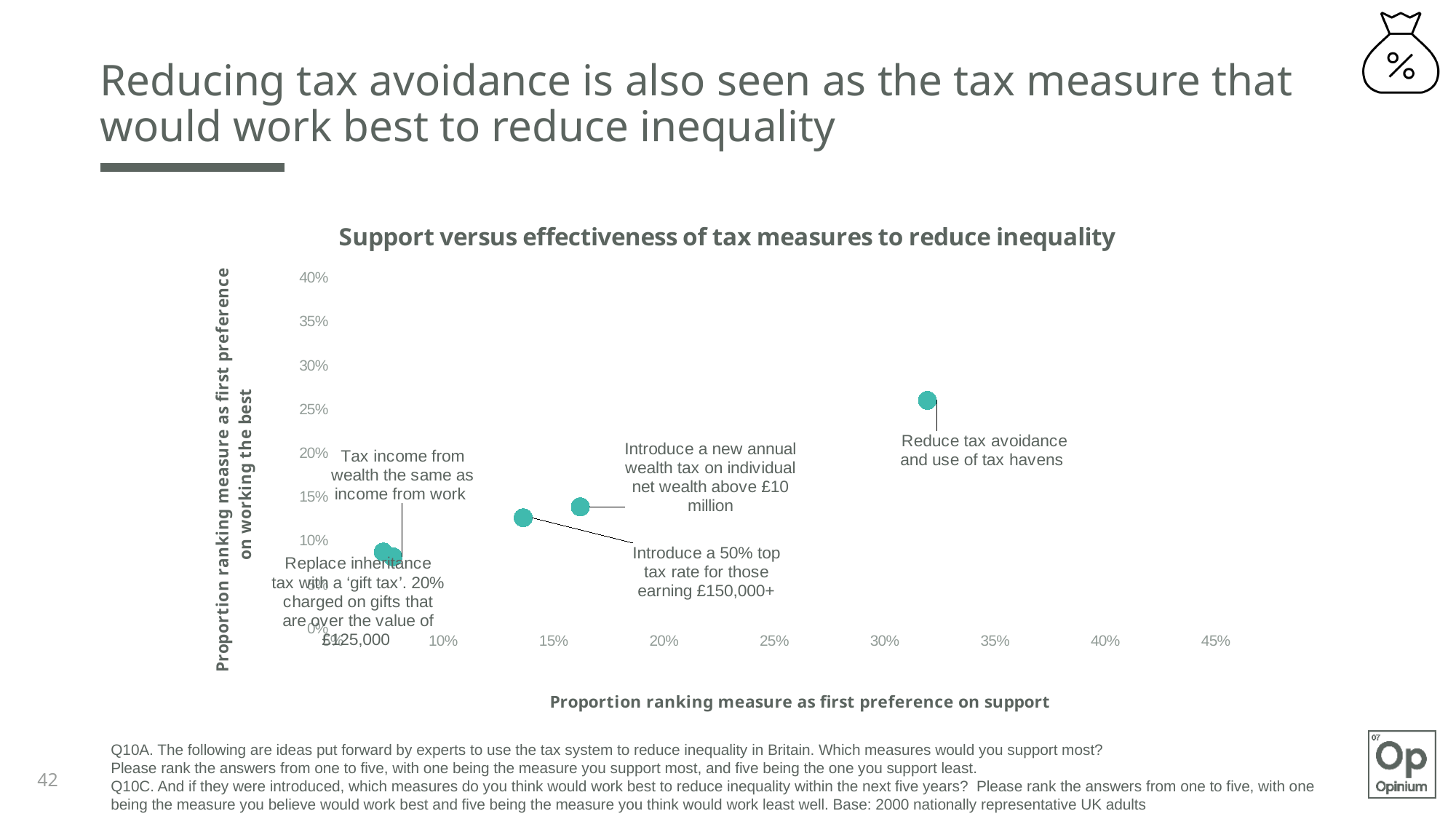
Which tax measure has the highest proportion ranking it as first preference on working the best? Reduce tax avoidance and use of tax havens Is the proportion ranking 'Reduce tax avoidance and use of tax havens' as first preference on support greater or less than 30%? greater Which tax measure has the highest proportion ranking it as first preference on support? Reduce tax avoidance and use of tax havens Which has a higher proportion ranking it as first preference on working the best: 'Introduce a 50% top tax rate for those earning £150,000+' or 'Tax income from wealth the same as income from work'? Introduce a 50% top tax rate for those earning £150,000+ Is the proportion ranking 'Introduce a 50% top tax rate for those earning £150,000+' as first preference on working the best greater or less than 15%? less What kind of chart is shown on the slide? Scatter chart Is the proportion ranking 'Reduce tax avoidance and use of tax havens' as first preference on working the best greater or less than 20%? greater How many tax measures are plotted on the chart? 5 What is the title of the chart? Support versus effectiveness of tax measures to reduce inequality What is the label of the horizontal axis? Proportion ranking measure as first preference on support Which has a higher proportion ranking it as first preference on support: 'Reduce tax avoidance and use of tax havens' or 'Introduce a new annual wealth tax on individual net wealth above £10 million'? Reduce tax avoidance and use of tax havens